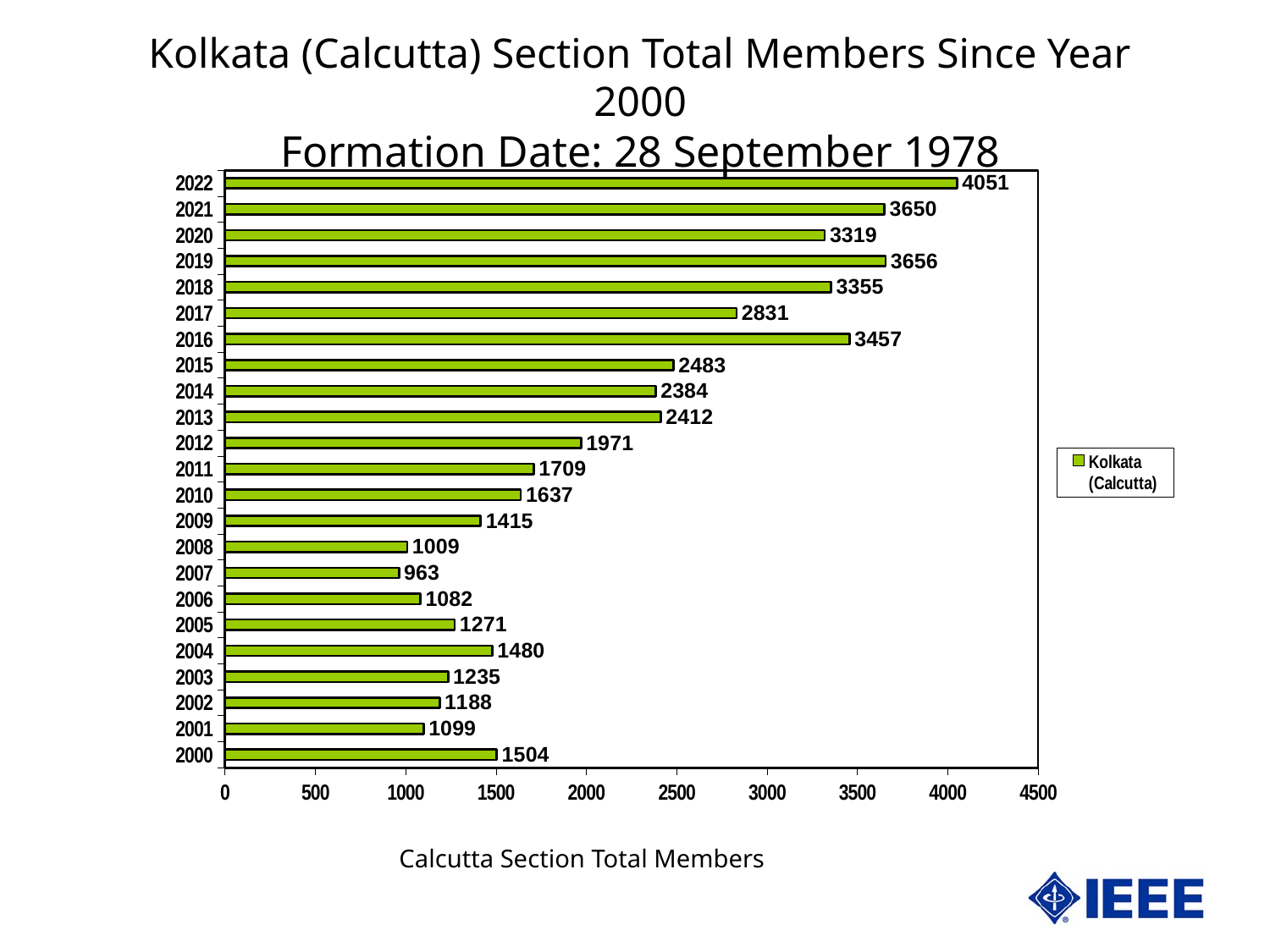
What kind of chart is shown on the slide? bar chart What is the legend entry for the series in the chart? Kolkata (Calcutta) Is the value for 2017 greater or less than 3000? less What is the total number of members for 2007? 963 How many years are shown in the chart? 23 Which year has the lowest number of members? 2007 How many series does the legend list? 1 Which year has the highest number of members? 2022 Which year has more members, 2019 or 2020? 2019 What is the total number of members for 2016? 3457 What is the difference in members between 2022 and 2021? 401 What is the total number of members for 2022? 4051